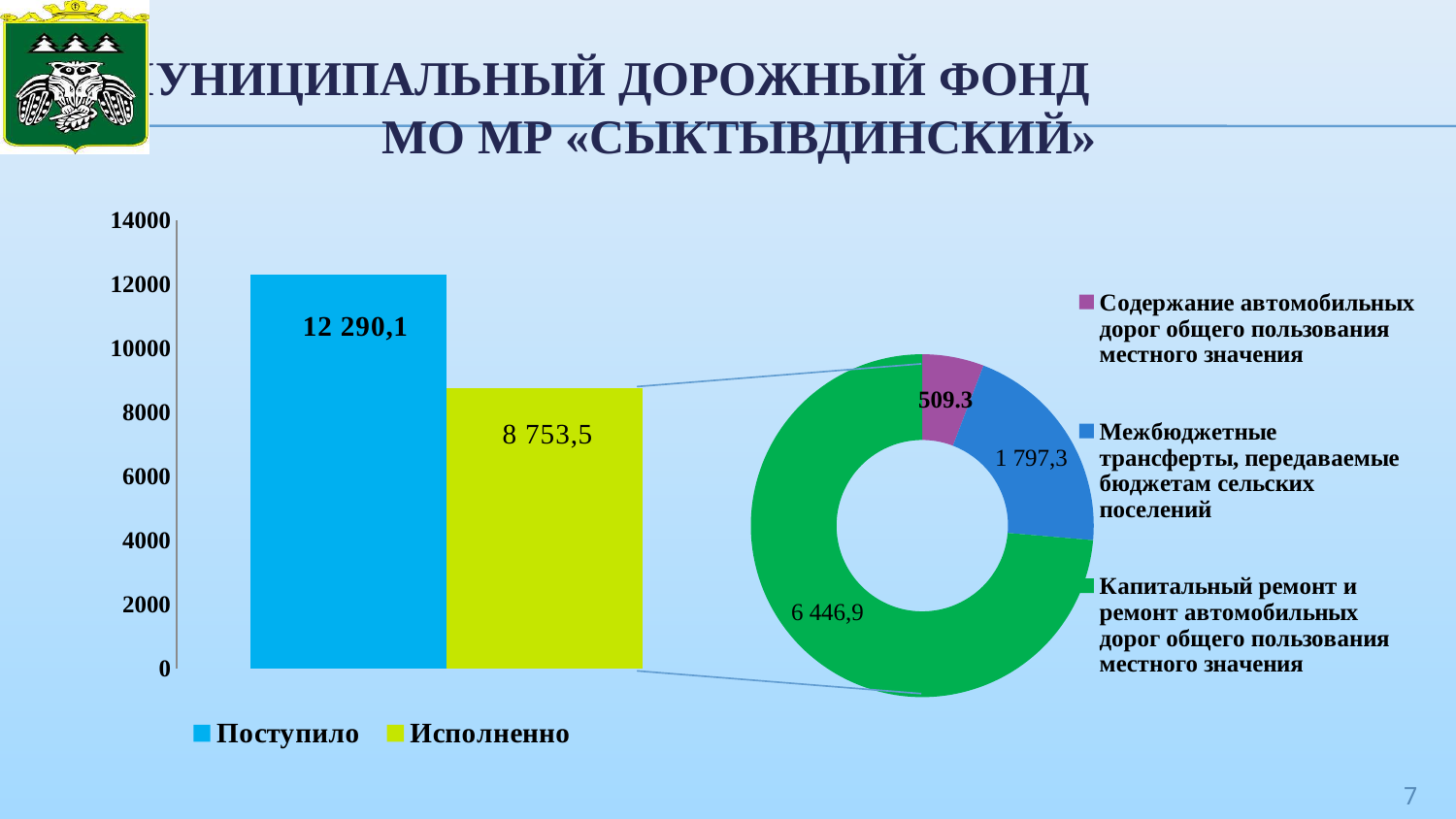
On the doughnut chart on the right, what is the value for Капитальный ремонт и ремонт автомобильных дорог общего пользования местного значения? 6 446,9 On the bar chart on the left, what is the value for Исполненно? 8 753,5 On the bar chart on the left, is the value for Исполненно greater or less than 8000? greater On the doughnut chart on the right, what is the value for Межбюджетные трансферты, передаваемые бюджетам сельских поселений? 1 797,3 On the doughnut chart on the right, how many categories are shown? 3 On the bar chart on the left, which series has the higher value, Поступило or Исполненно? Поступило On the doughnut chart on the right, what is the difference between Межбюджетные трансферты, передаваемые бюджетам сельских поселений and Содержание автомобильных дорог общего пользования местного значения? 1 288,0 On the doughnut chart on the right, which category has the smallest value? Содержание автомобильных дорог общего пользования местного значения What kind of chart is the chart on the left of the slide? Bar chart On the bar chart on the left, how many series does the legend list? 2 On the bar chart on the left, what is the difference between Поступило and Исполненно? 3 536,6 On the bar chart on the left, what is the value for Поступило? 12 290,1